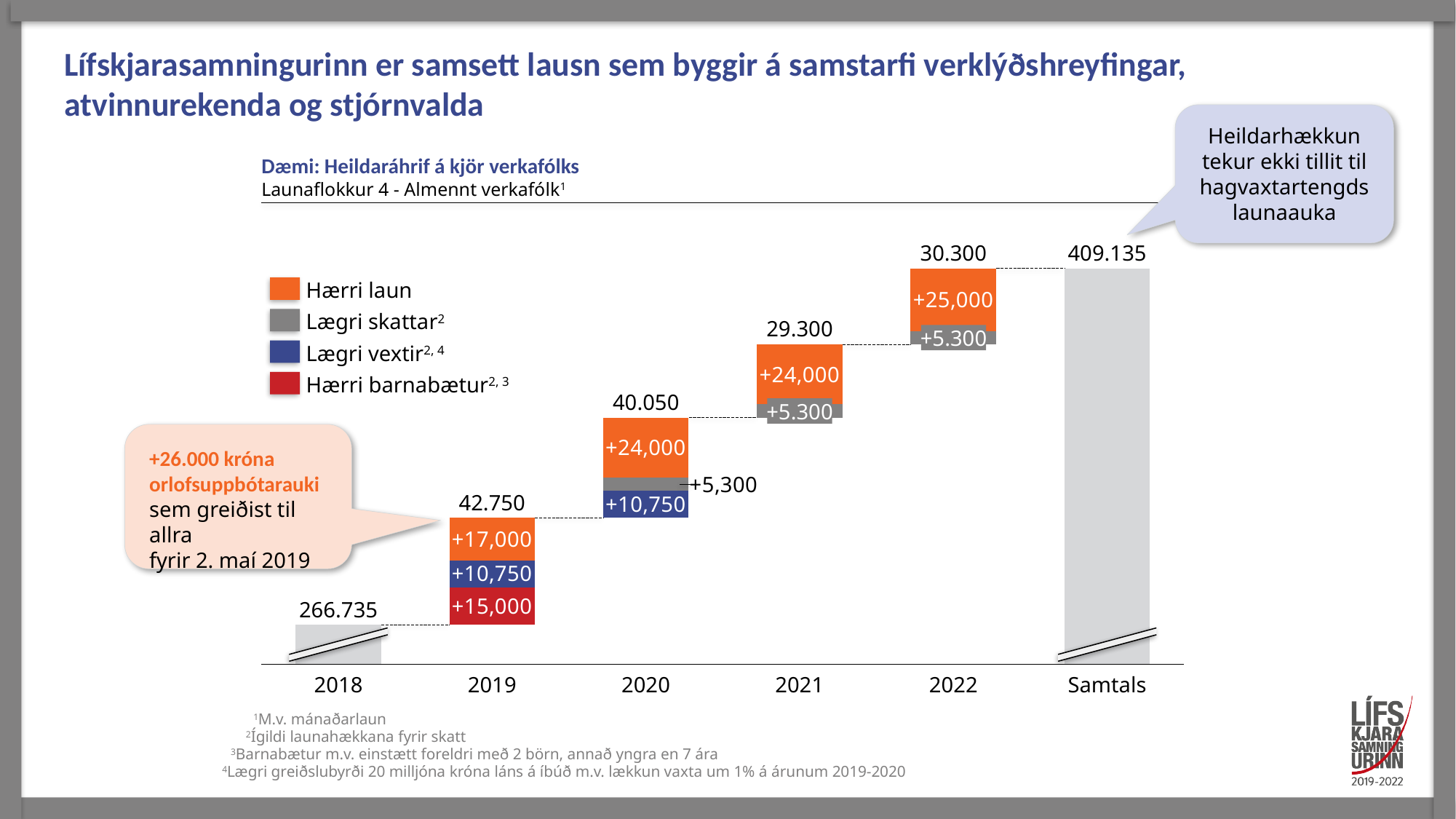
What is the Hærri laun value shown in the 2022 bar? +25,000 What is the Lægri vextir value shown in the 2020 bar? +10,750 How many categories are shown along the x axis? 6 What is the Hærri barnabætur value shown in the 2019 bar? +15,000 What is the difference between the Hærri laun value in 2022 and the Hærri laun value in 2021? 1,000 How many entries does the legend list? 4 What kind of chart is shown on the slide? bar chart Among the years 2019 to 2022, which year has the smallest total increase labelled above its bar? 2021 What is the total increase labelled above the 2019 bar? 42.750 Which has a larger total increase labelled above its bar, 2020 or 2021? 2020 What value is labelled above the Samtals bar? 409.135 Among the years 2019 to 2022, which year has the largest total increase labelled above its bar? 2019